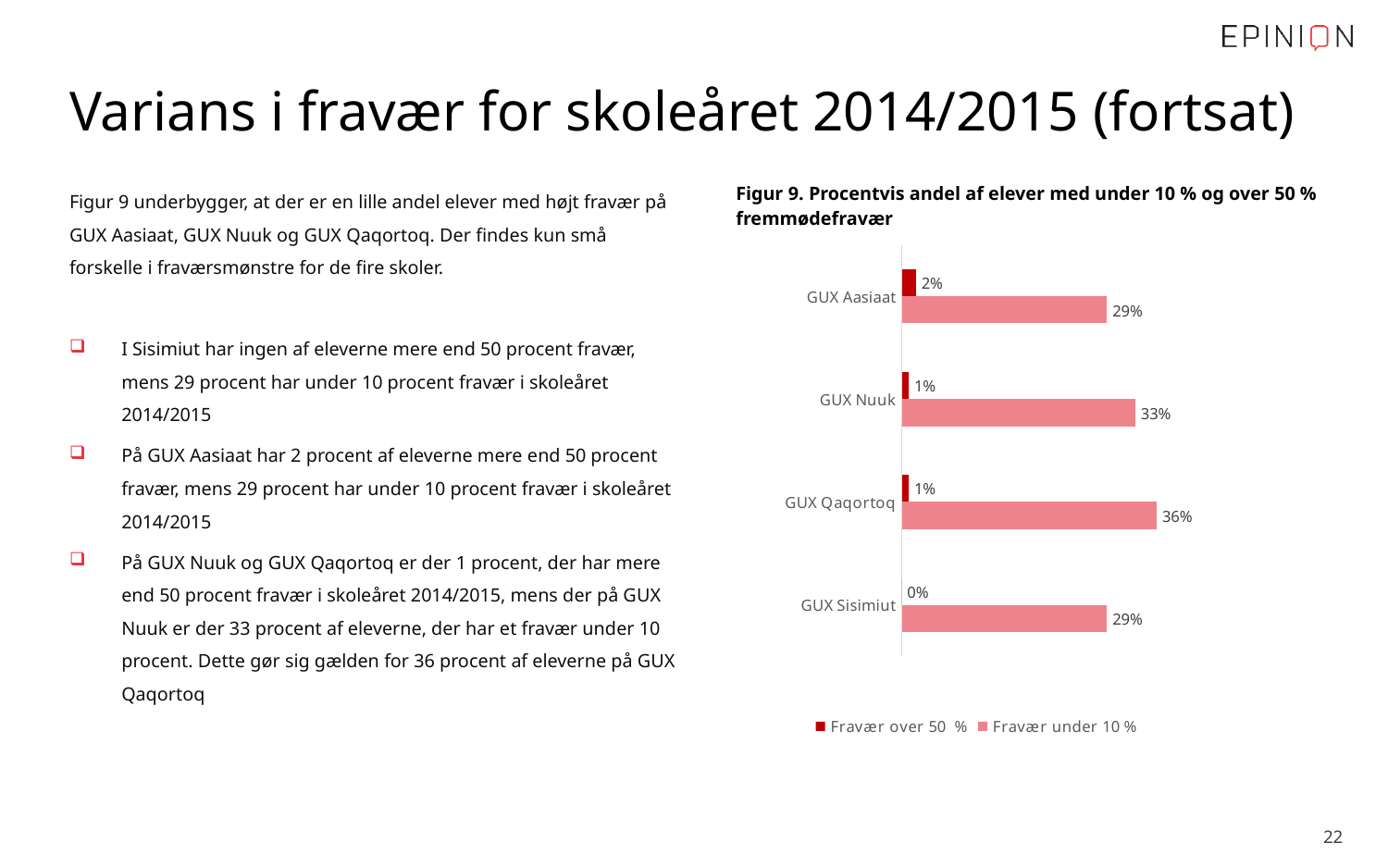
What kind of chart is shown on the slide? Bar chart How many series does the legend list? 2 What is the difference between the 'Fravær under 10 %' values for GUX Qaqortoq and GUX Aasiaat? 7% How many schools are shown in the chart? 4 What is the value of 'Fravær under 10 %' for GUX Nuuk? 33% What is the value of 'Fravær over 50 %' for GUX Aasiaat? 2% Which is larger: 'Fravær under 10 %' for GUX Nuuk or for GUX Sisimiut? GUX Nuuk Which school has the lowest value for 'Fravær over 50 %'? GUX Sisimiut What is the value of 'Fravær over 50 %' for GUX Sisimiut? 0% What is the title of the chart? Figur 9. Procentvis andel af elever med under 10 % og over 50 % fremmødefravær Which school has the highest value for 'Fravær under 10 %'? GUX Qaqortoq What is the value of 'Fravær under 10 %' for GUX Qaqortoq? 36%